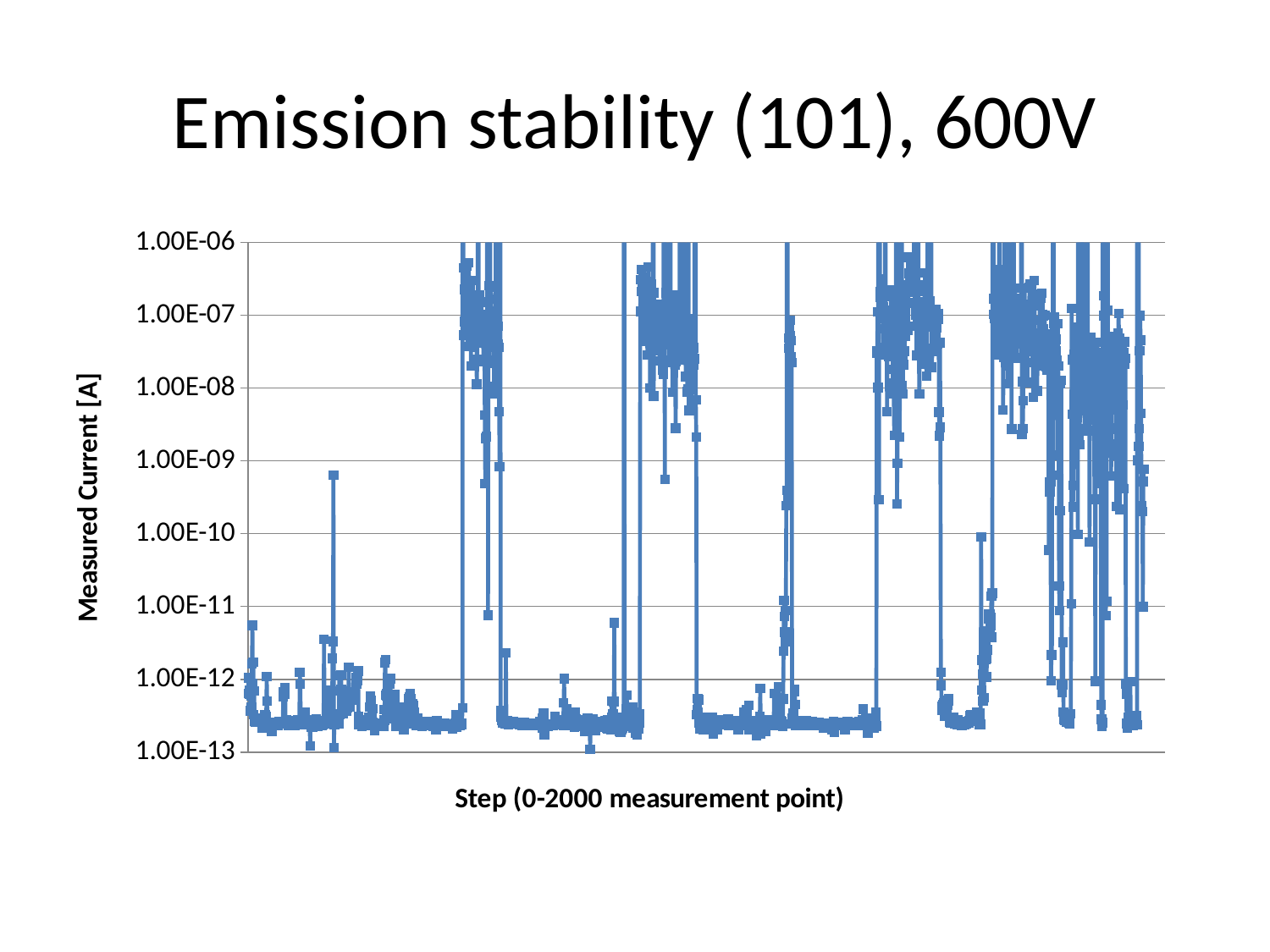
What is the highest value shown on the y axis? 1.00E-06 What is the label of the y axis? Measured Current [A] What is the title of the chart? Emission stability (101), 600V Is the baseline measured current during the quiet periods greater or less than 1.00E-12? less Is the measured current during the emission bursts greater or less than 1.00E-09? greater How many labelled tick values are shown on the y axis? 8 What kind of chart is shown on the slide? line chart What is the lowest value shown on the y axis? 1.00E-13